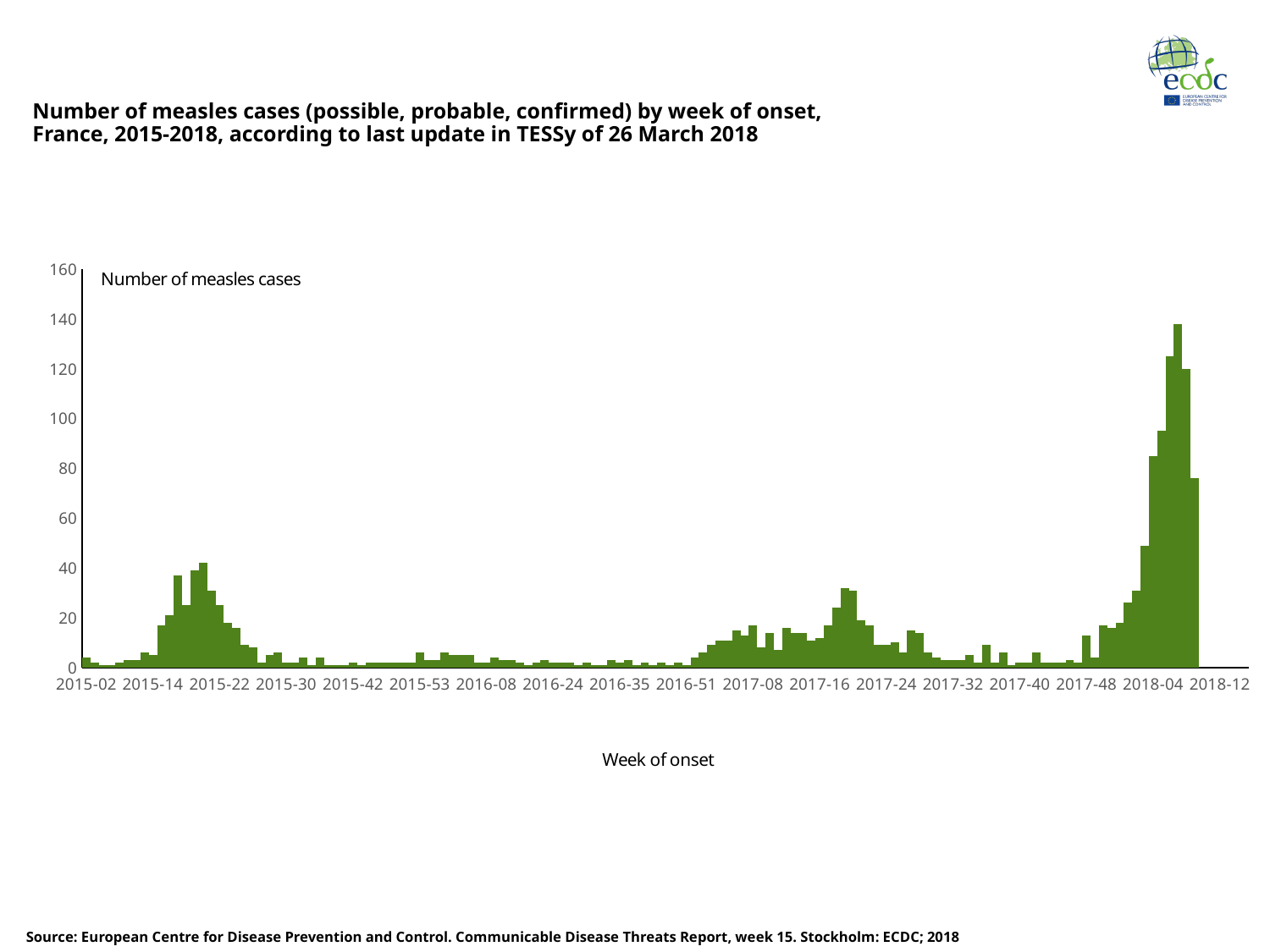
Is the value for the peak around week 2015-22 greater or less than 60? less Is the value for the peak around week 2017-16 greater or less than 20? greater Do the values rise or fall between week 2017-48 and week 2018-04? rise What kind of chart is shown on the slide? bar chart Is the value for week 2016-24 greater or less than 20? less Around which labelled week on the x axis does the highest bar occur? 2018-04 What is the label of the x axis? Week of onset Which is larger: the peak around week 2015-22 or the peak around week 2018-04? the peak around 2018-04 What is the highest value shown on the y axis? 160